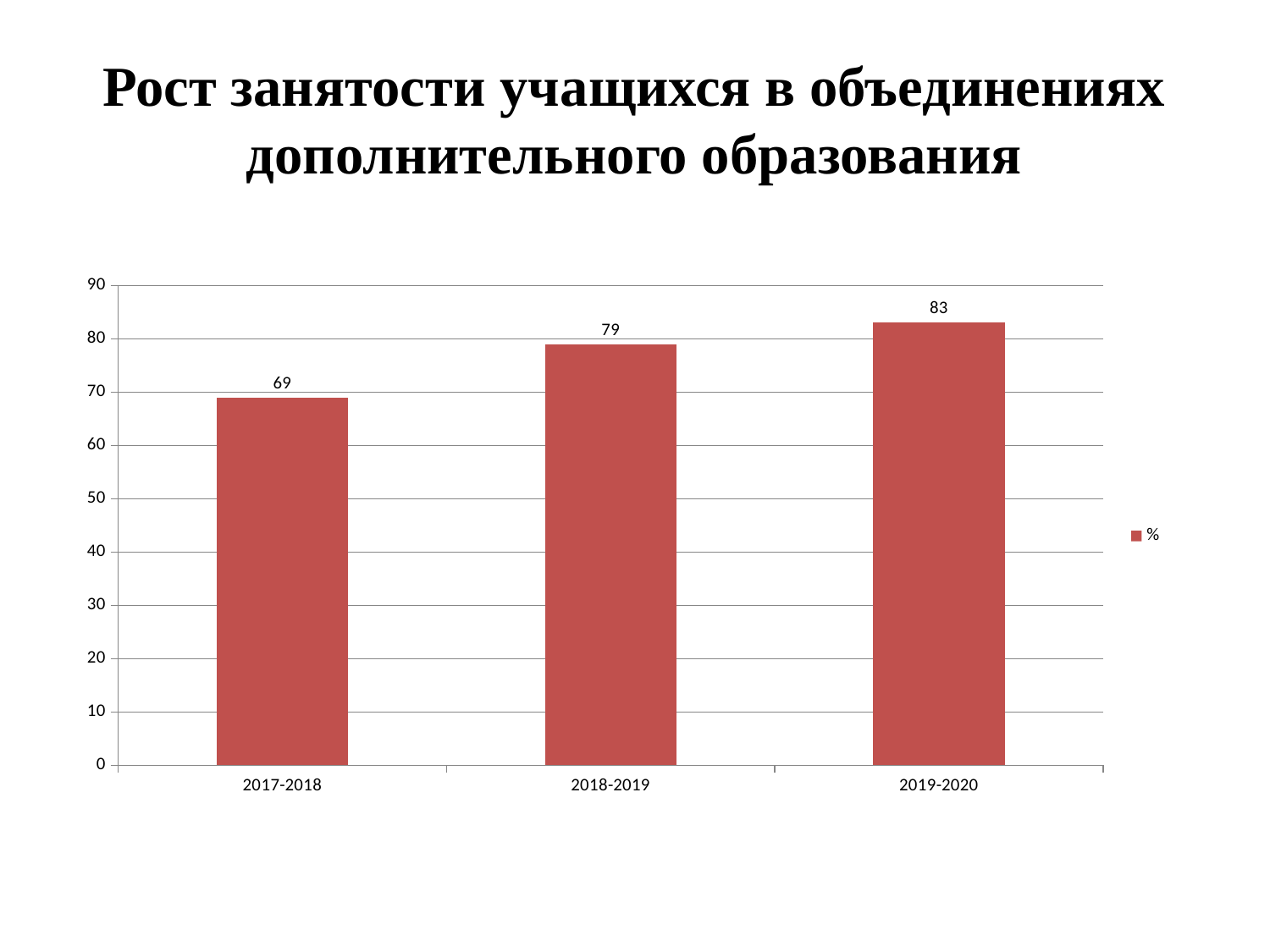
Which year has the highest value? 2019-2020 How many categories are shown on the x axis? 3 What is the value for 2019-2020? 83 What is the value for 2017-2018? 69 What kind of chart is shown on the slide? bar chart What is the difference between the values for 2019-2020 and 2017-2018? 14 Do the values rise or fall from 2017-2018 to 2019-2020? rise Is the value for 2018-2019 greater or less than 70? greater Which year has the lowest value? 2017-2018 What is the value for 2018-2019? 79 What is the difference between the values for 2018-2019 and 2017-2018? 10 Which is larger, the value for 2018-2019 or the value for 2019-2020? 2019-2020